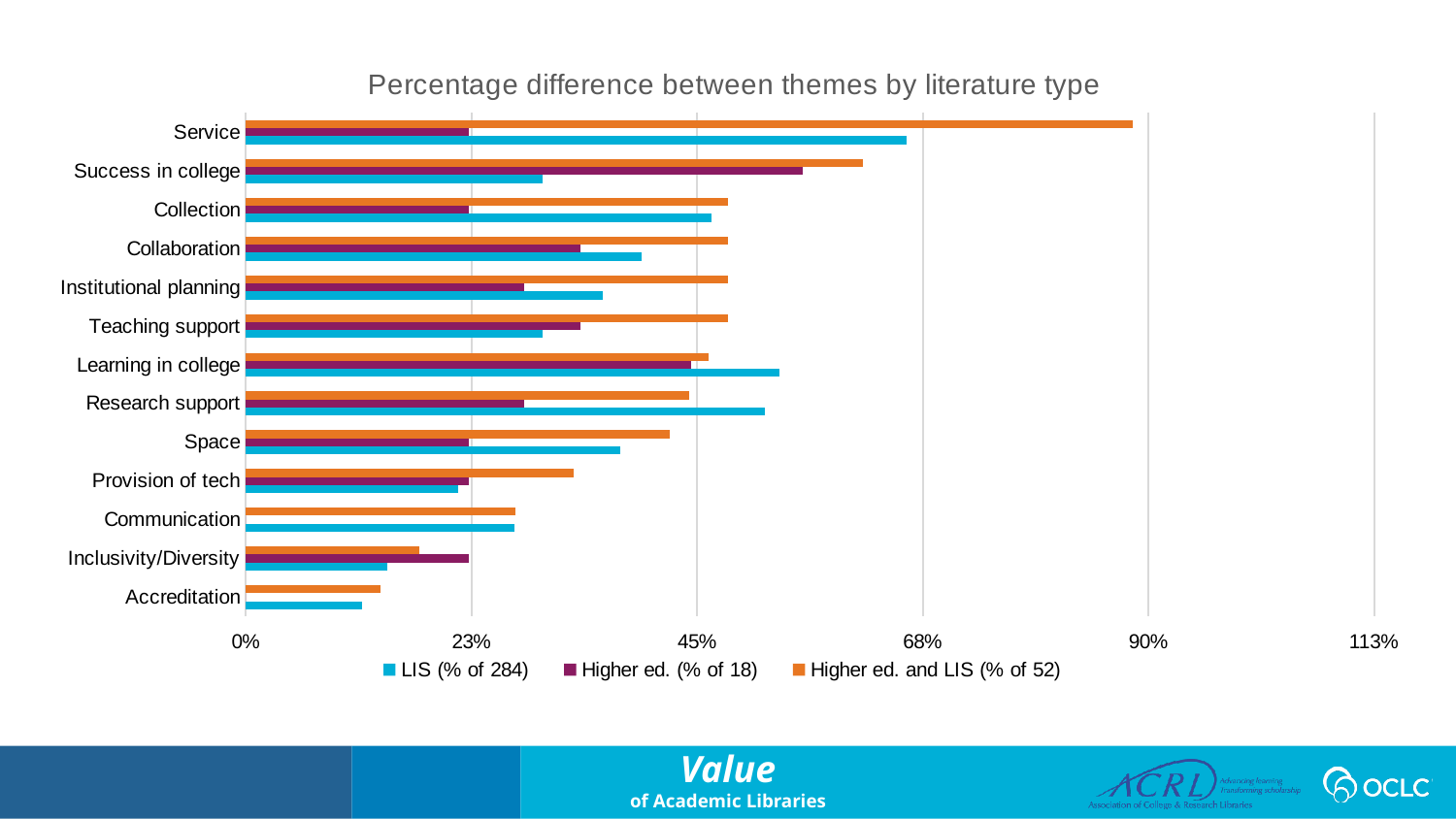
How many theme categories are plotted on the chart? 13 Is the Higher ed. and LIS (% of 52) value for Service greater or less than 90%? less How many series does the legend list? 3 Which theme has the highest value for the Higher ed. (% of 18) series? Success in college Is the LIS (% of 284) value for Accreditation greater or less than 23%? less Which theme has the lowest value for the LIS (% of 284) series? Accreditation Which theme has the highest value for the LIS (% of 284) series? Service What is the title of the chart? Percentage difference between themes by literature type What kind of chart is shown on the slide? bar chart Which theme has the highest value for the Higher ed. and LIS (% of 52) series? Service For Learning in college, which is larger: the LIS (% of 284) value or the Higher ed. (% of 18) value? LIS (% of 284) Is the Higher ed. and LIS (% of 52) value for Success in college greater or less than 45%? greater